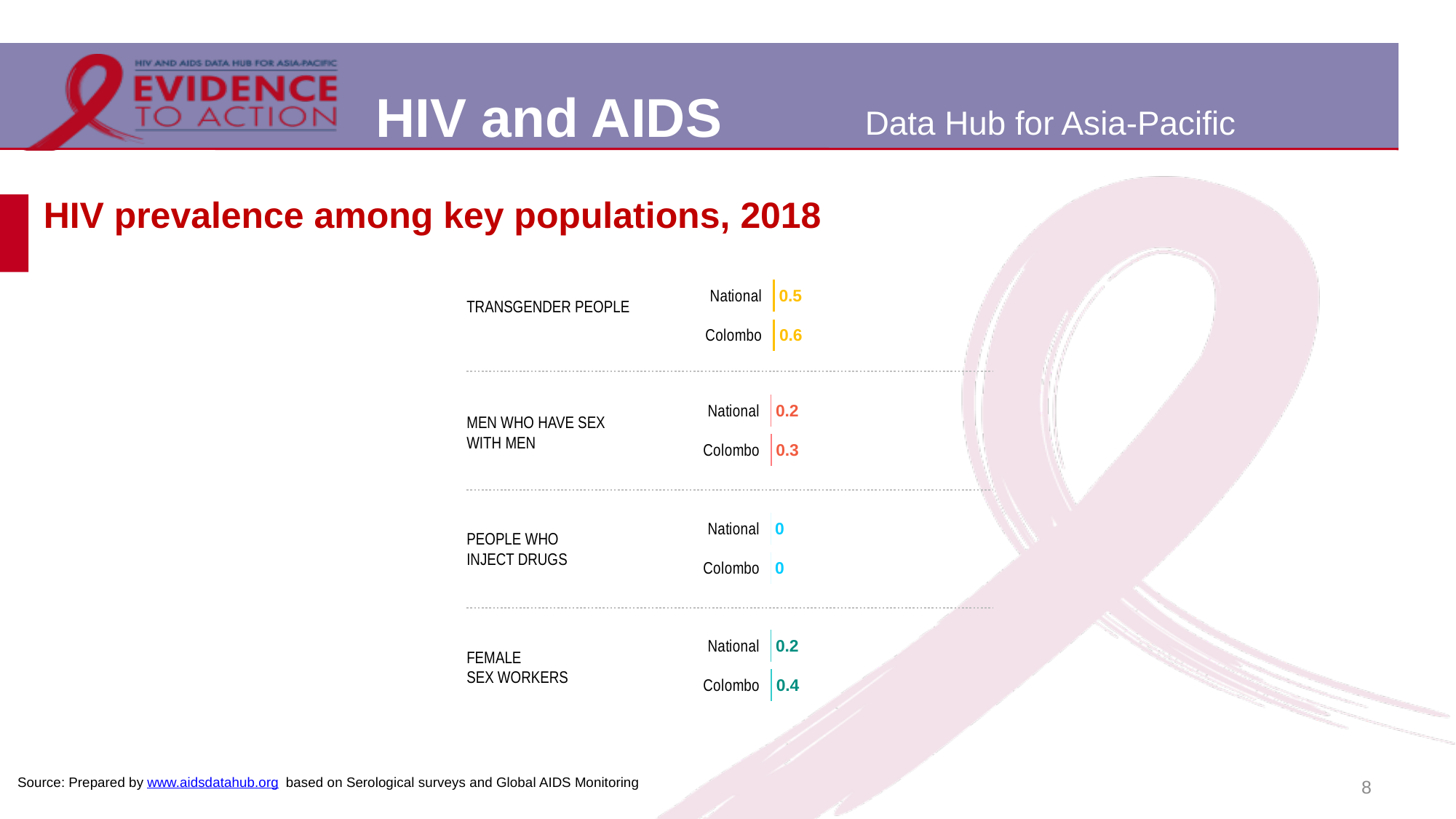
Which key population has the highest HIV prevalence in Colombo? Transgender people Which key population has the lowest national HIV prevalence? People who inject drugs How many key populations are shown in the chart? 4 What is the HIV prevalence among transgender people in Colombo? 0.6 What is the HIV prevalence among female sex workers in Colombo? 0.4 What is the title of the chart on the slide? HIV prevalence among key populations, 2018 Is the HIV prevalence among men who have sex with men higher nationally or in Colombo? Colombo What is the national HIV prevalence among people who inject drugs? 0 What is the difference between the Colombo and national HIV prevalence among female sex workers? 0.2 What kind of chart is used to show HIV prevalence among key populations? Bar chart What is the national HIV prevalence among men who have sex with men? 0.2 What is the national HIV prevalence among transgender people? 0.5